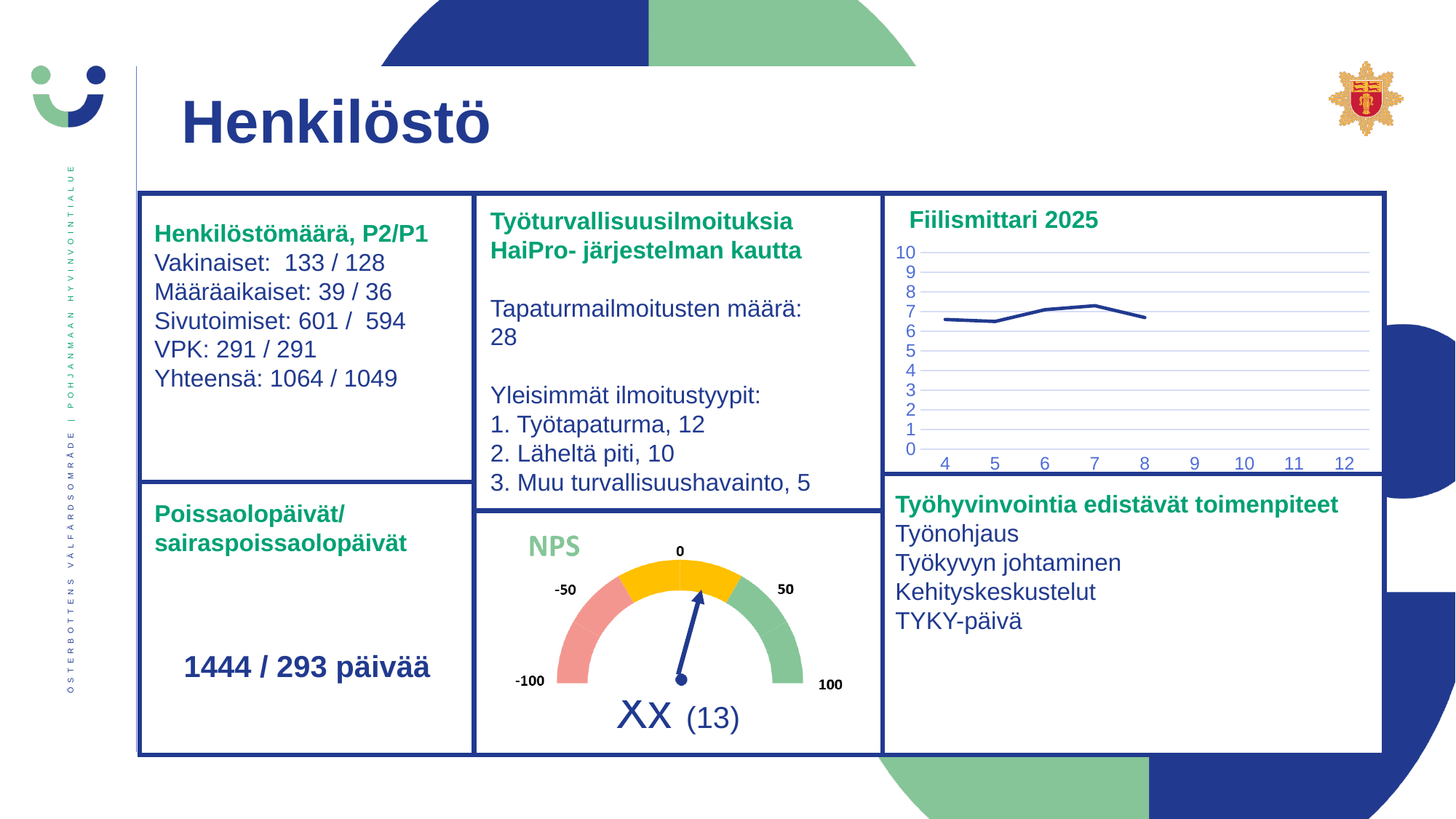
In the Fiilismittari 2025 chart, is the value at x = 7 greater or less than 8? less What is the title of the line chart on the right of the slide? Fiilismittari 2025 In the Fiilismittari 2025 chart, does the line rise or fall between x = 5 and x = 7? rise In the Fiilismittari 2025 chart, what is the highest value shown on the y axis? 10 In the Fiilismittari 2025 chart, does the line rise or fall between x = 7 and x = 8? fall What kind of chart is the NPS chart in the bottom middle of the slide? gauge chart In the Fiilismittari 2025 chart, is the value at x = 8 greater or less than 6? greater In the Fiilismittari 2025 chart, at which x-axis value does the line reach its highest point? 7 In the Fiilismittari 2025 chart, is the value at x = 4 greater or less than 5? greater In the Fiilismittari 2025 chart, how many data points are plotted on the line? 5 In the Fiilismittari 2025 chart, which is larger, the value at x = 7 or the value at x = 5? x = 7 What kind of chart is the Fiilismittari 2025 chart? line chart